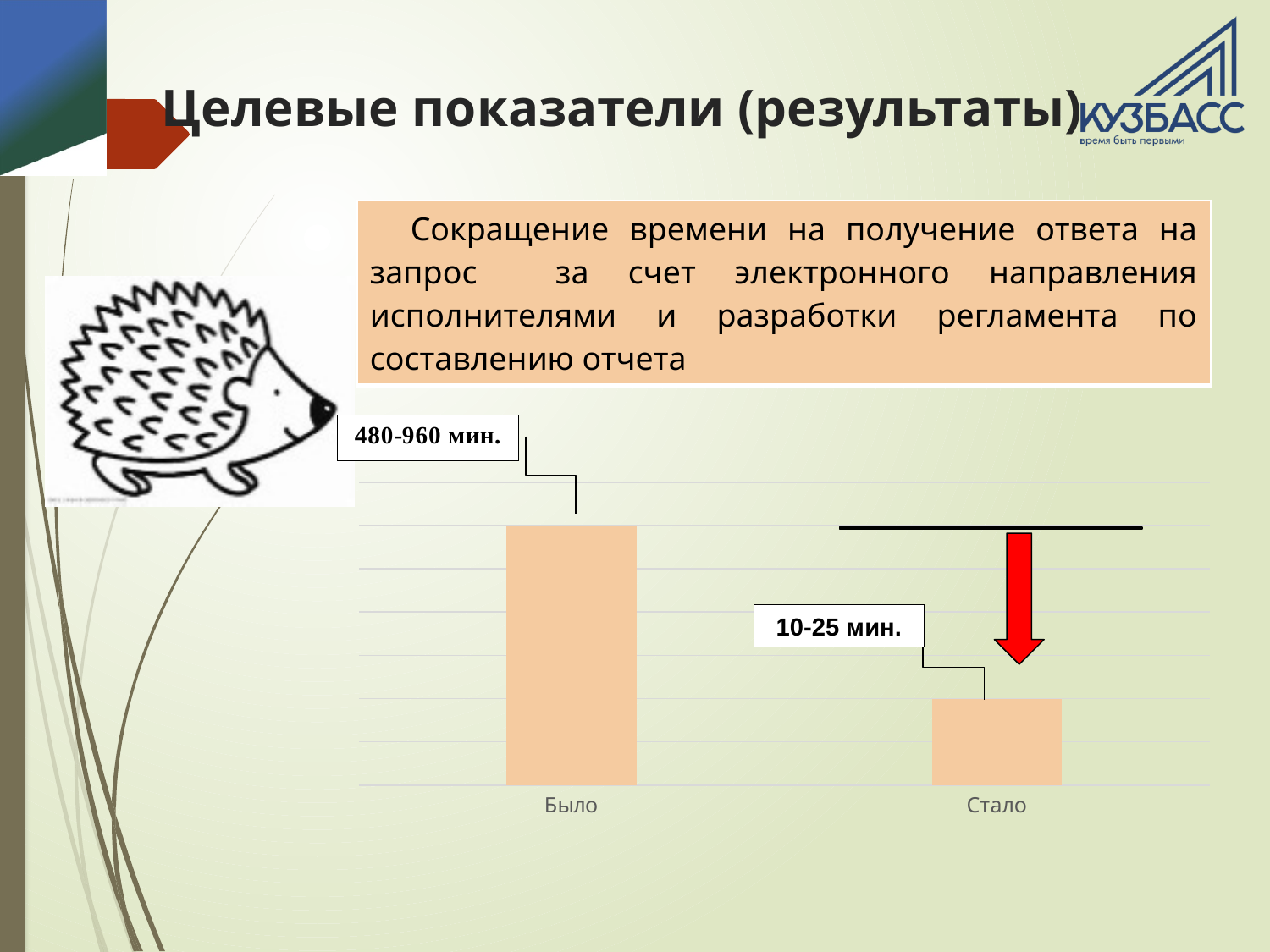
What are the two category labels on the x axis, from left to right? Было, Стало Is the bar for "Было" larger or smaller than the bar for "Стало"? larger How many categories are shown on the x axis of the chart? 2 Which category has the shorter bar? Стало What colour are the bars in the chart? light orange (peach) What value is labelled for the "Стало" bar? 10-25 мин. Which category has the taller bar? Было What kind of chart is shown on the slide? bar chart Do the values rise or fall from "Было" to "Стало"? fall What value is labelled for the "Было" bar? 480-960 мин.